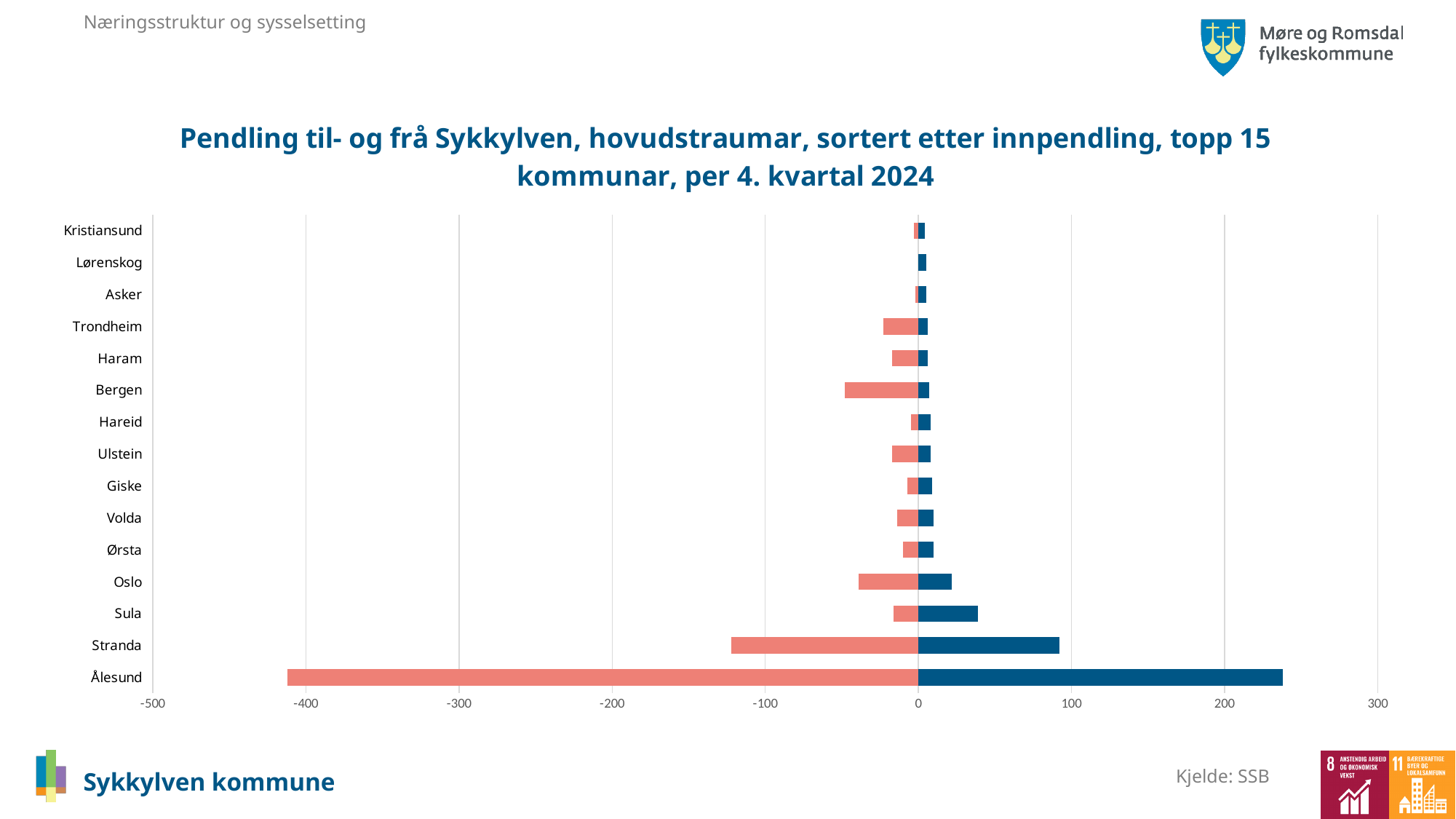
Is the value of the blue bar for Ålesund greater or less than 200? greater What kind of chart is shown on the slide? bar chart Which municipality has the longest red bar extending to the left? Ålesund What is the title of the chart? Pendling til- og frå Sykkylven, hovudstraumar, sortert etter innpendling, topp 15 kommunar, per 4. kvartal 2024 Which has the longer blue bar, Stranda or Sula? Stranda How many municipalities are listed on the vertical axis of the chart? 15 Is the value of the blue bar for Stranda greater or less than 100? less Is the value of the red bar for Oslo greater or less than -100? greater Which municipality has the longest blue bar extending to the right? Ålesund Which has the longer red bar, Bergen or Trondheim? Bergen